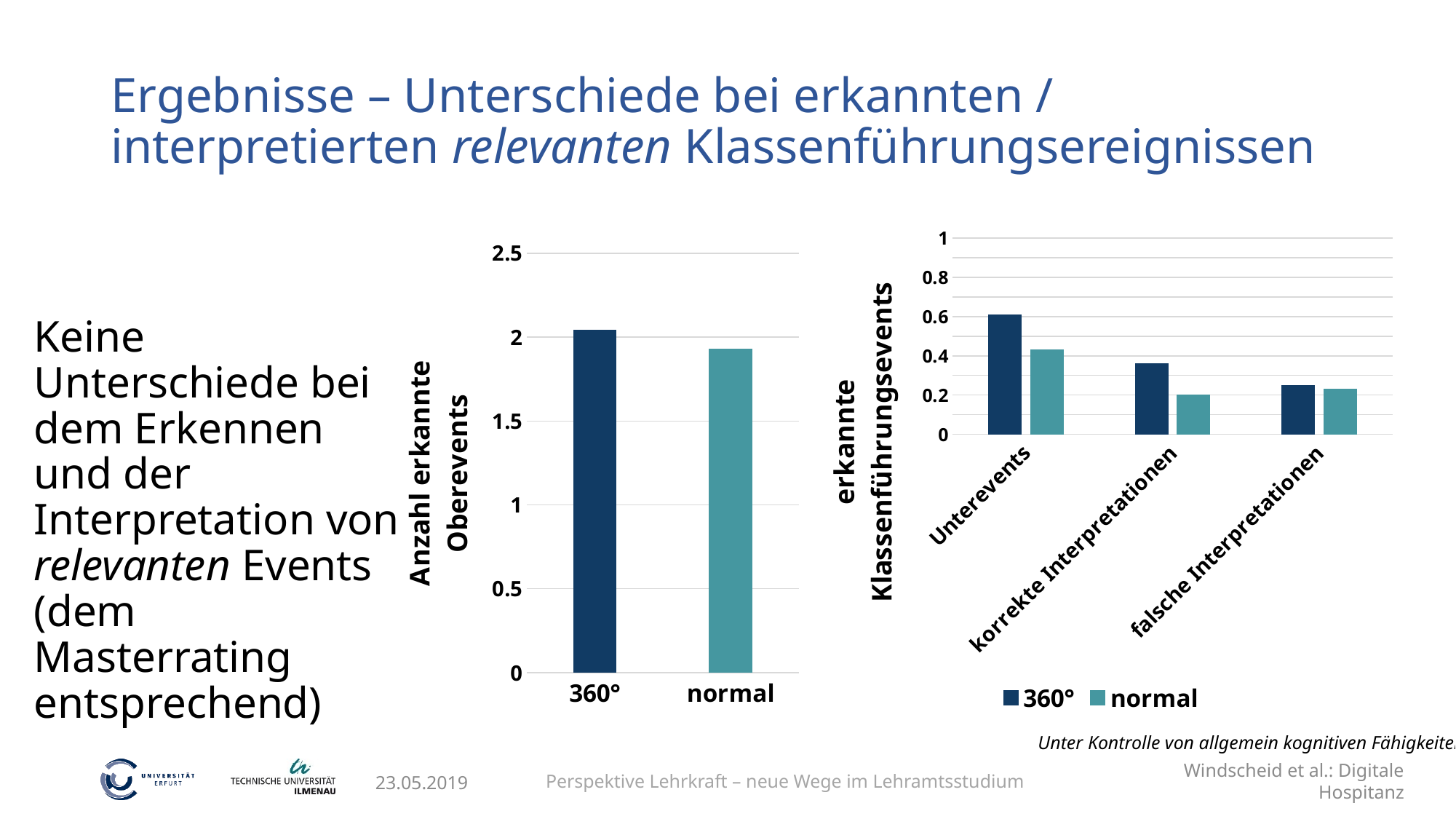
In the right chart (erkannte Klassenführungsevents), which category has the lowest value for the 360° series? falsche Interpretationen In the left chart (Anzahl erkannte Oberevents), is the value for normal greater or less than 2? less What kind of chart is the left chart (Anzahl erkannte Oberevents)? bar chart In the right chart (erkannte Klassenführungsevents), how many series does the legend list? 2 In the right chart (erkannte Klassenführungsevents), how many categories are shown on the x axis? 3 In the right chart (erkannte Klassenführungsevents), which category has the highest value for the 360° series? Unterevents In the left chart (Anzahl erkannte Oberevents), which category has the higher bar, 360° or normal? 360° In the left chart (Anzahl erkannte Oberevents), is the value for 360° greater or less than 1.5? greater In the right chart (erkannte Klassenführungsevents), is the 360° value for Unterevents greater or less than 0.4? greater In the right chart (erkannte Klassenführungsevents), for Unterevents, which series has the larger value, 360° or normal? 360° In the left chart (Anzahl erkannte Oberevents), how many categories are shown on the x axis? 2